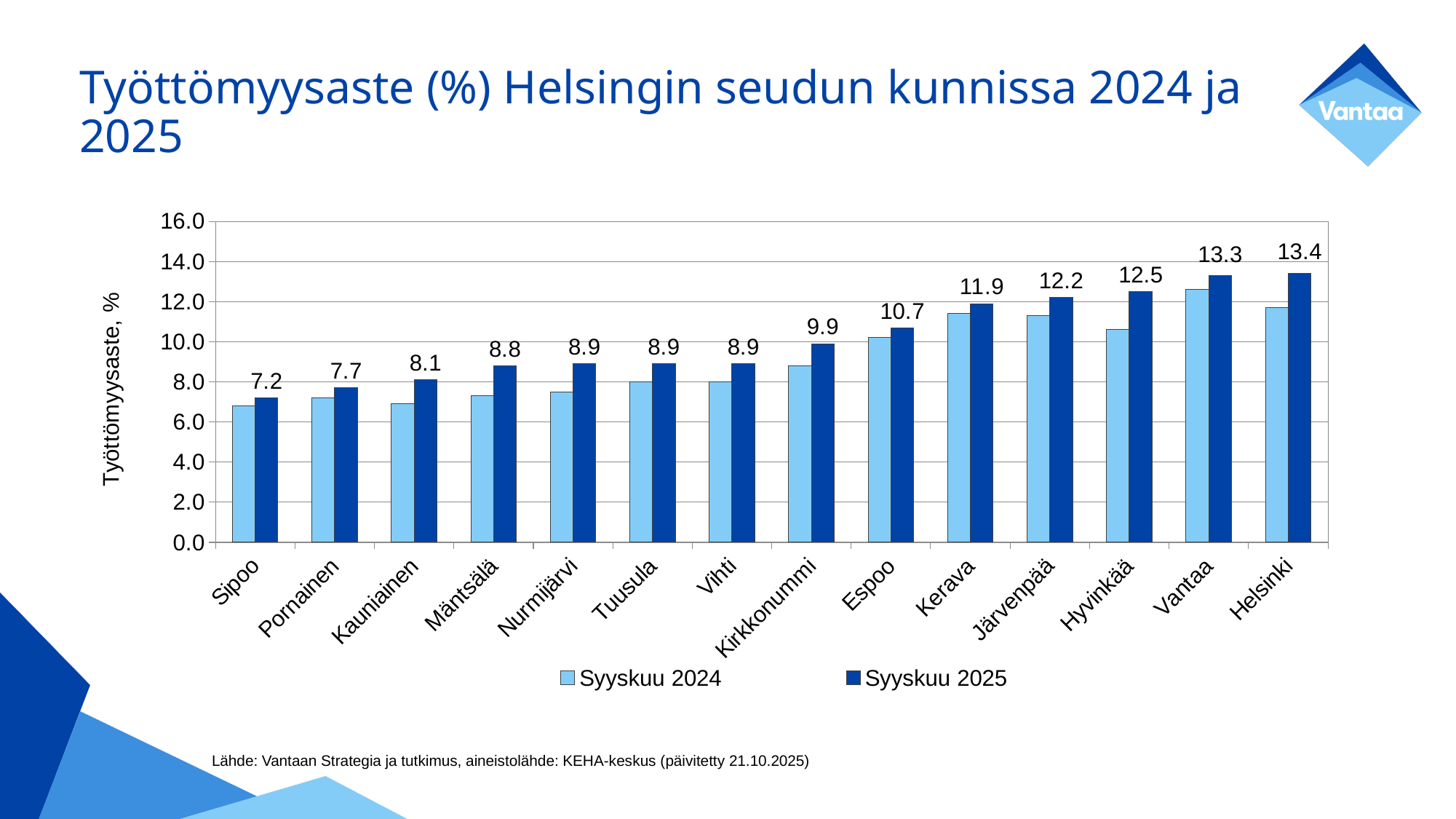
What is the difference between the Syyskuu 2025 values for Helsinki and Sipoo? 6.2 What is the Syyskuu 2025 value for Kirkkonummi? 9.9 What kind of chart is shown on the slide? bar chart How many municipalities are shown on the x axis? 14 Is the Syyskuu 2024 value for Helsinki greater or less than 12.0? less What is the Syyskuu 2025 unemployment rate for Sipoo? 7.2 Which municipality has the lowest Syyskuu 2025 unemployment rate? Sipoo What is the Syyskuu 2025 unemployment rate for Helsinki? 13.4 Which has the larger Syyskuu 2025 value, Järvenpää or Kerava? Järvenpää Which municipality has the highest Syyskuu 2025 unemployment rate? Helsinki Is the Syyskuu 2024 value for Sipoo greater or less than 8.0? less How many series does the legend list? 2